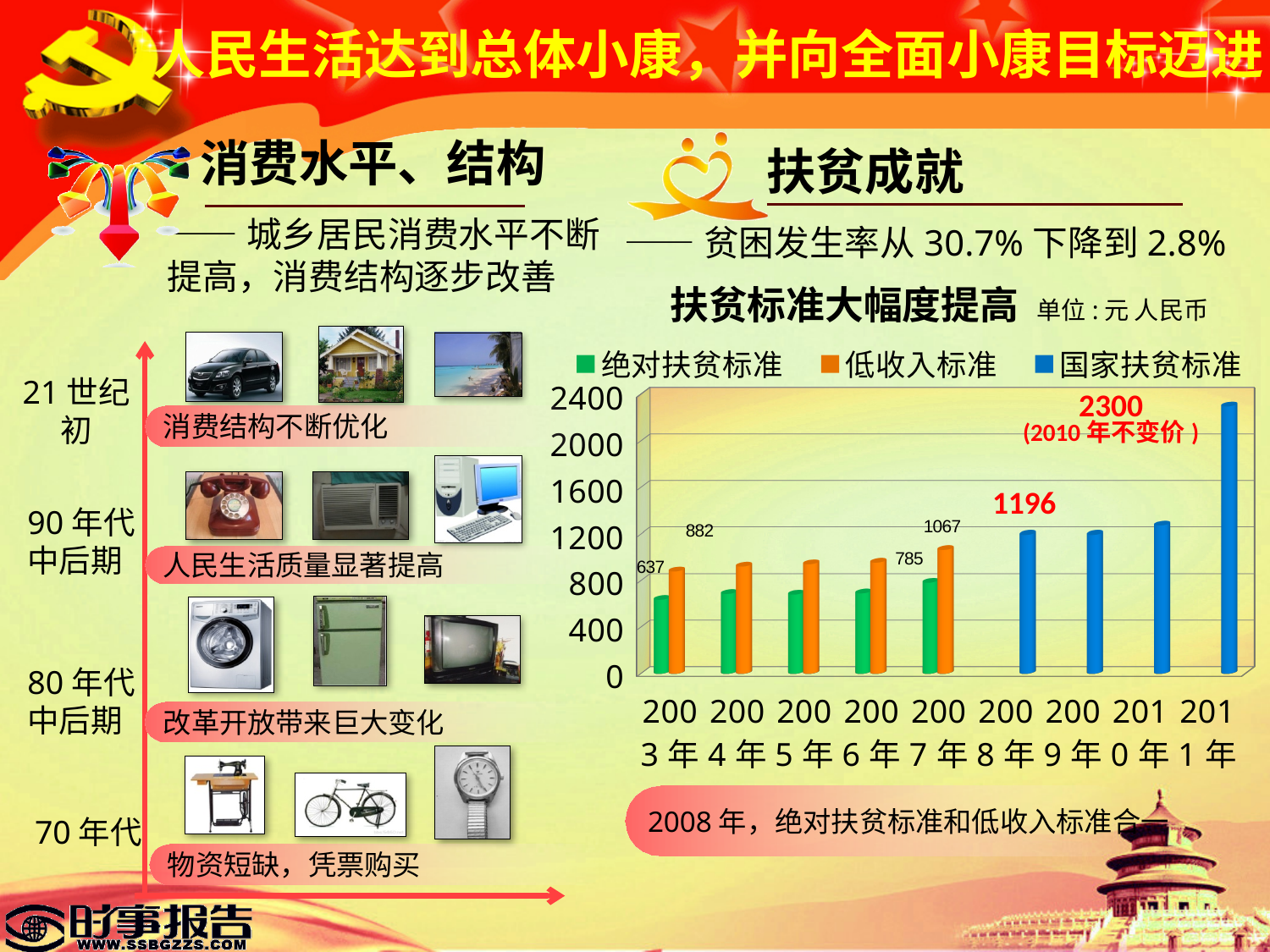
In the 扶贫标准大幅度提高 chart, what is the 绝对扶贫标准 value for 2007年? 785 In the 扶贫标准大幅度提高 chart, what is the 国家扶贫标准 value for 2008年? 1196 In the 扶贫标准大幅度提高 chart, what is the 低收入标准 value for 2007年? 1067 In the 扶贫标准大幅度提高 chart, how much higher is the 国家扶贫标准 in 2011年 than in 2008年? 1104 In the 扶贫标准大幅度提高 chart, what is the 低收入标准 value for 2003年? 882 In the 扶贫标准大幅度提高 chart, what is the difference between the 低收入标准 and 绝对扶贫标准 values for 2003年? 245 How many series does the legend of the 扶贫标准大幅度提高 chart list? 3 In the 扶贫标准大幅度提高 chart, what is the 国家扶贫标准 value for 2011年? 2300 How many years are shown on the x axis of the 扶贫标准大幅度提高 chart? 9 In the 扶贫标准大幅度提高 chart, which year has the highest bar? 2011年 In the 扶贫标准大幅度提高 chart, is the 低收入标准 value for 2004年 greater or less than 1200? less In the 扶贫标准大幅度提高 chart, what is the 绝对扶贫标准 value for 2003年? 637